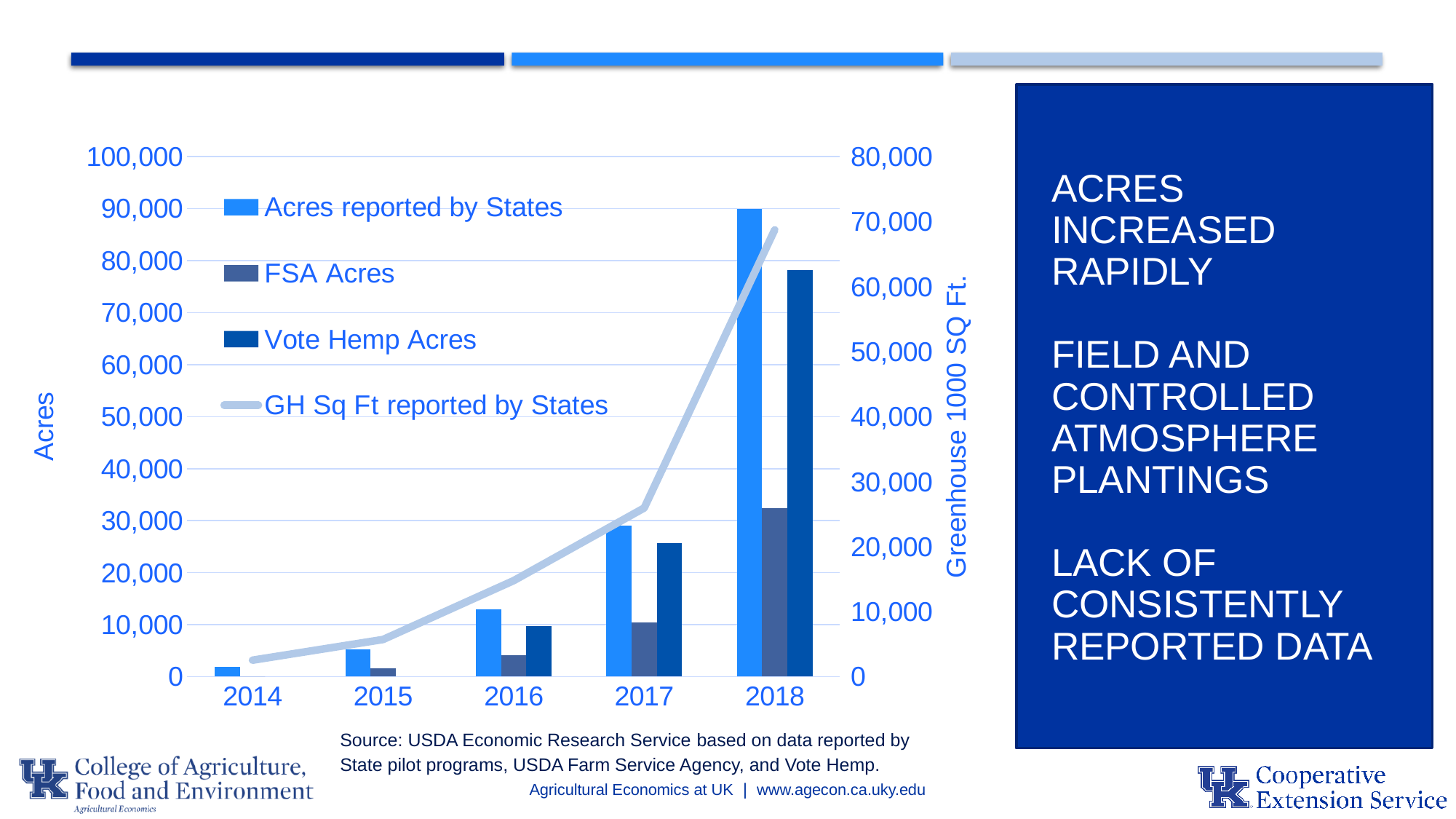
What is the label of the right-hand vertical axis? Greenhouse 1000 SQ Ft. Is the value for Vote Hemp Acres in 2018 greater or less than 70,000? greater In 2017, which is larger: FSA Acres or Vote Hemp Acres? Vote Hemp Acres Do the values for Acres reported by States rise or fall from 2014 to 2018? rise How many years are shown on the x axis? 5 How many series does the legend list? 4 In which year is the value for Acres reported by States lowest? 2014 In which year is the value for Acres reported by States highest? 2018 Is the value for Acres reported by States in 2017 greater or less than 20,000? greater Is the value for FSA Acres in 2018 greater or less than 40,000? less In 2018, which is larger: Acres reported by States or Vote Hemp Acres? Acres reported by States What kind of chart is shown on the slide? bar chart with a line